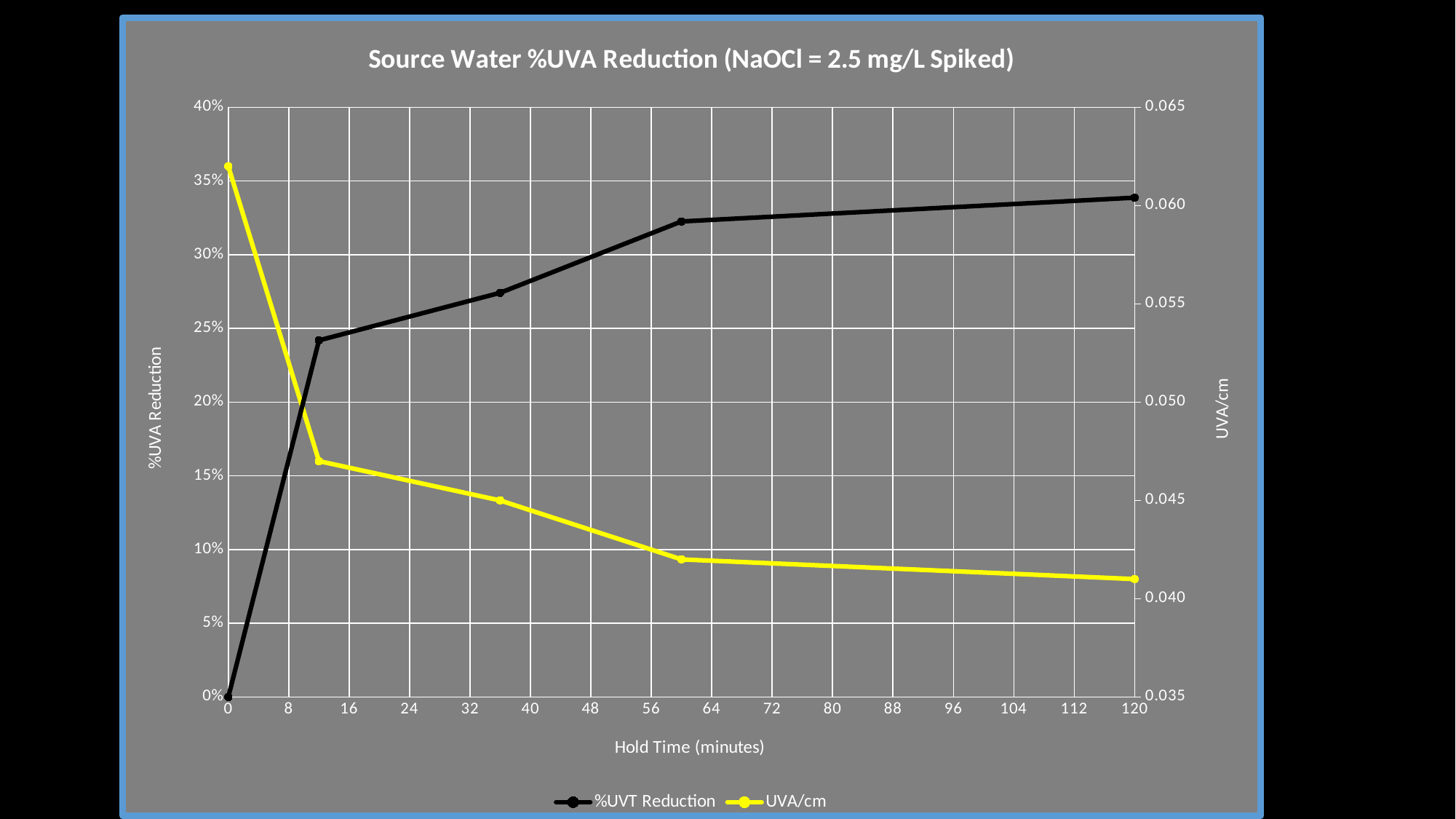
Does the UVA/cm series rise or fall as hold time increases? fall How many data points are plotted for the %UVT Reduction series? 5 Is the UVA/cm value at 120 minutes greater or less than 0.045? less What is the %UVT Reduction value at a hold time of 0 minutes? 0% Does the %UVT Reduction series rise or fall as hold time increases? rise Is the %UVT Reduction value at 120 minutes greater or less than 30%? greater How many series does the legend list? 2 Is the UVA/cm value at 0 minutes greater or less than 0.060? greater What kind of chart is shown on the slide? line chart At which hold time is the UVA/cm value highest? 0 minutes What is the label of the x axis? Hold Time (minutes)